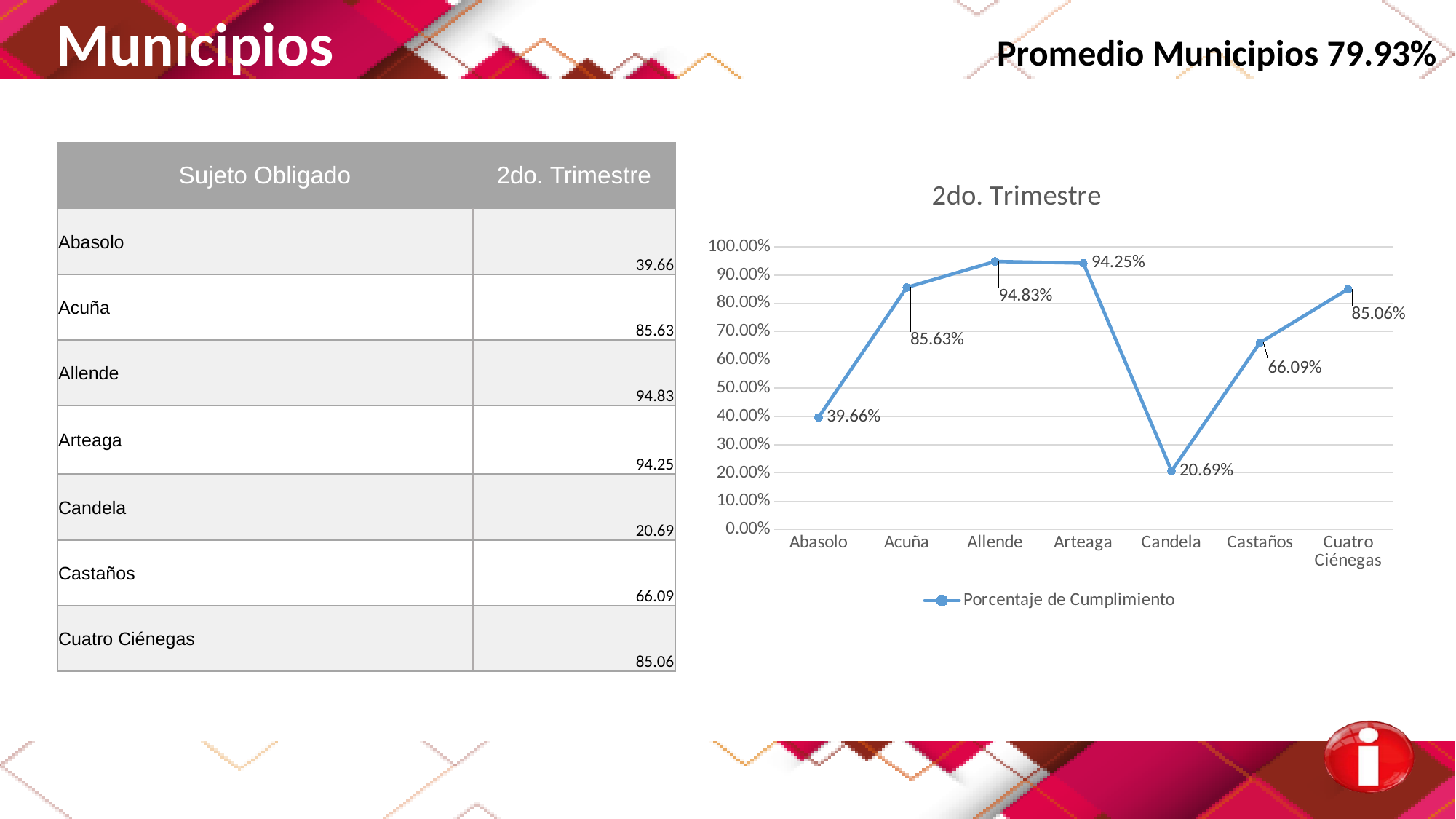
What is the difference between the values for Acuña and Abasolo in the 2do. Trimestre chart? 45.97% What kind of chart is the 2do. Trimestre chart? Line chart What is the value for Candela in the 2do. Trimestre chart? 20.69% What is the value for Allende in the 2do. Trimestre chart? 94.83% Which municipality has the highest value in the 2do. Trimestre chart? Allende Which municipality has the lowest value in the 2do. Trimestre chart? Candela How many series does the legend of the 2do. Trimestre chart list? 1 Which is larger in the 2do. Trimestre chart, the value for Castaños or the value for Cuatro Ciénegas? Cuatro Ciénegas What is the name of the series shown in the legend of the 2do. Trimestre chart? Porcentaje de Cumplimiento How many municipalities are plotted on the x axis of the 2do. Trimestre chart? 7 What is the value for Cuatro Ciénegas in the 2do. Trimestre chart? 85.06% Is the value for Arteaga in the 2do. Trimestre chart greater or less than 90.00%? greater